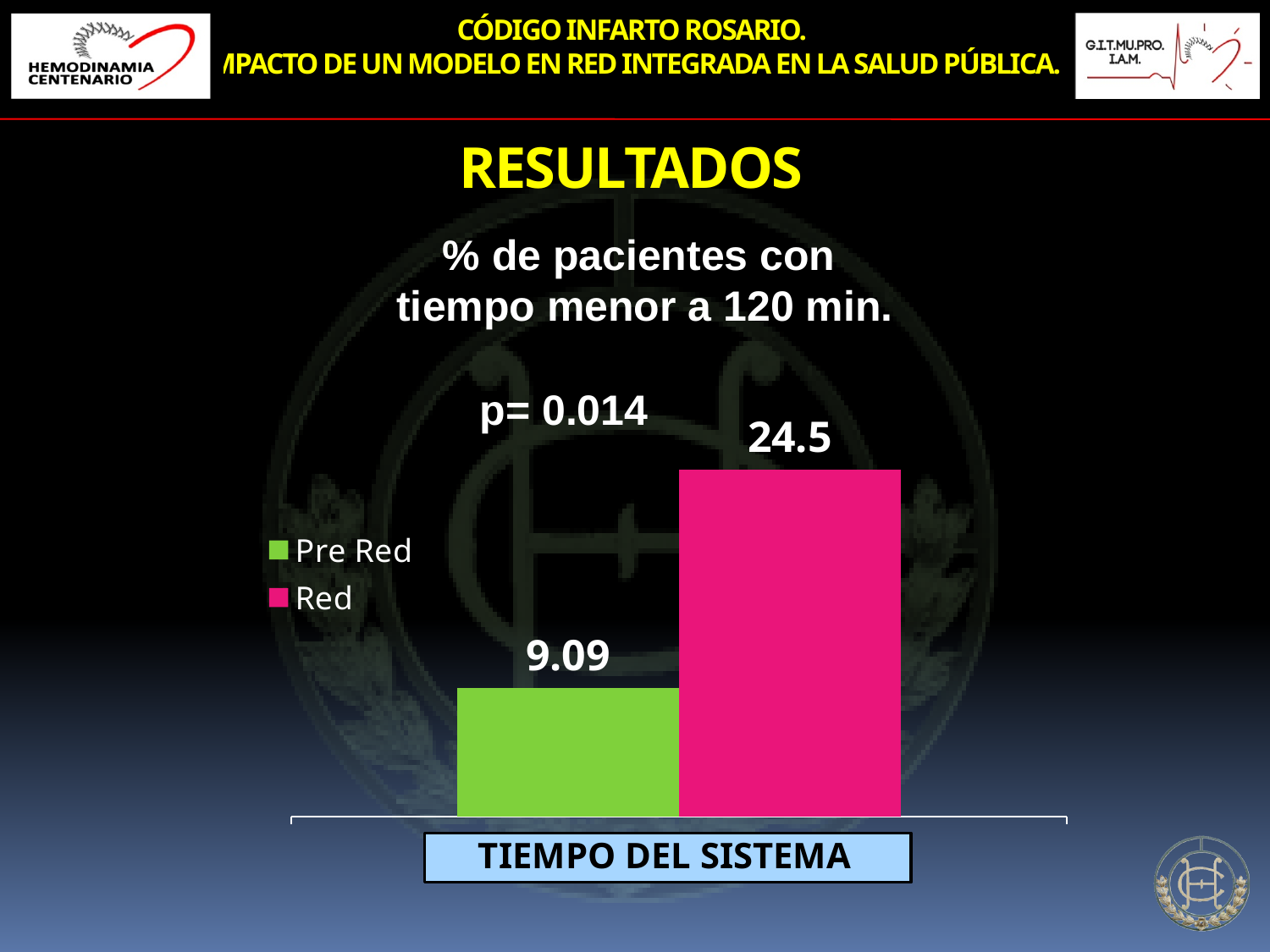
What kind of chart is shown on the slide? Bar chart What is the value for Pre Red in the chart? 9.09 What is the difference between the Red value and the Pre Red value? 15.41 Which series has the highest value in the chart? Red How many series does the legend list? 2 What is the value for Red in the chart? 24.5 What is the category label shown below the chart's x axis? TIEMPO DEL SISTEMA What colour is the bar for the Red series? Pink Which series has the lowest value in the chart? Pre Red Which series has the higher value, Pre Red or Red? Red How many bars are plotted in the chart? 2